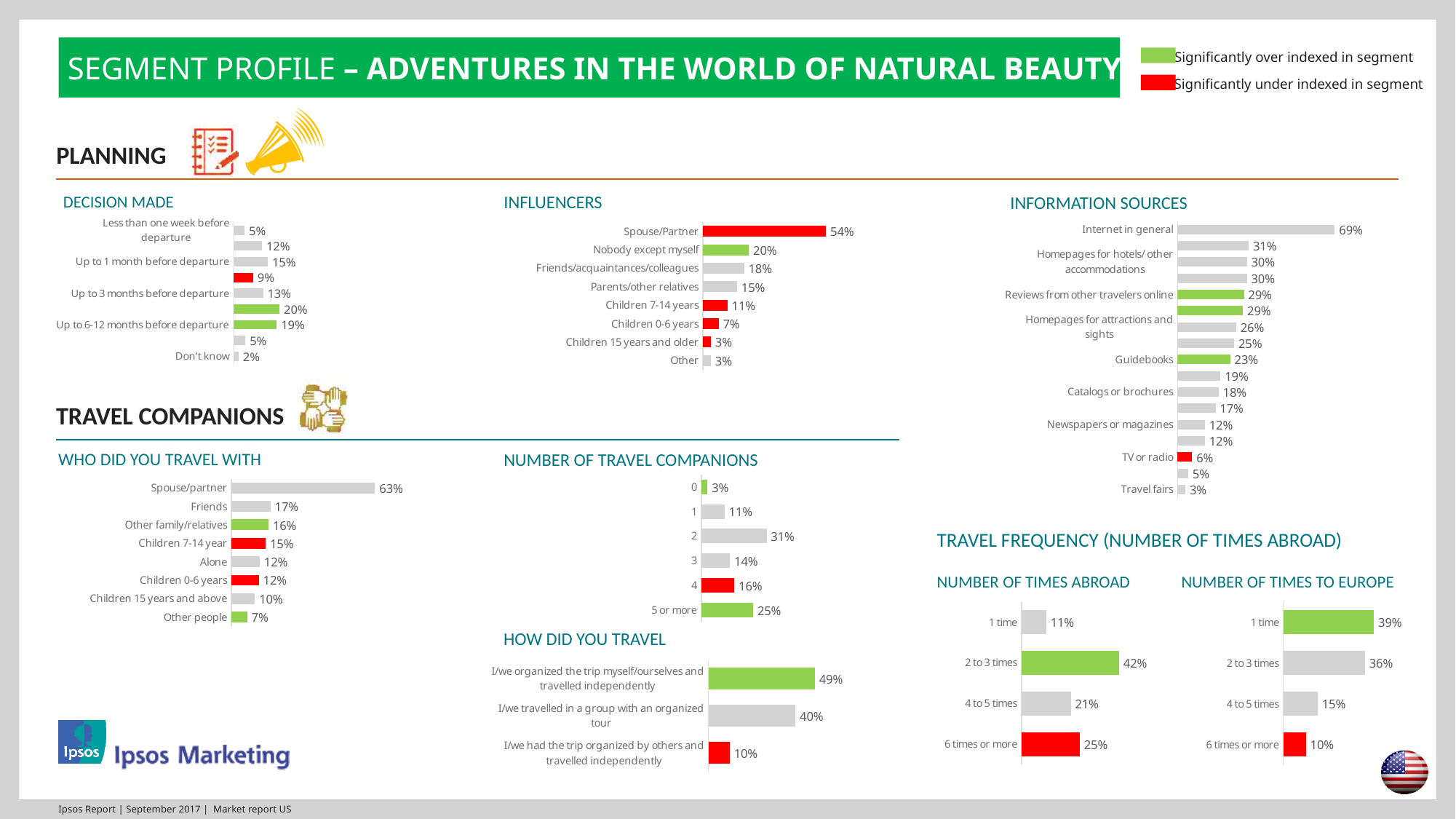
What kind of chart is the "Number of Times to Europe" chart? Bar chart How many categories are shown in the "How Did You Travel" chart? 3 In the "Number of Times Abroad" chart, what is the value for 2 to 3 times? 42% In the "Information Sources" chart, which category has the highest value? Internet in general In the "Number of Travel Companions" chart, what is the difference between the values for 2 and 3 companions? 17% In the "Influencers" chart, what is the value for Spouse/Partner? 54% In the "Influencers" chart, what is the value for Children 0-6 years? 7% In the "Number of Travel Companions" chart, which is larger: the value for 4 or the value for 5 or more? 5 or more In the "Who Did You Travel With" chart, which category has the lowest value? Other people In the "Number of Times to Europe" chart, what is the difference between the values for 1 time and 6 times or more? 29% In the "How Did You Travel" chart, what is the value for "I/we travelled in a group with an organized tour"? 40% In the "Who Did You Travel With" chart, what is the value for Friends? 17%